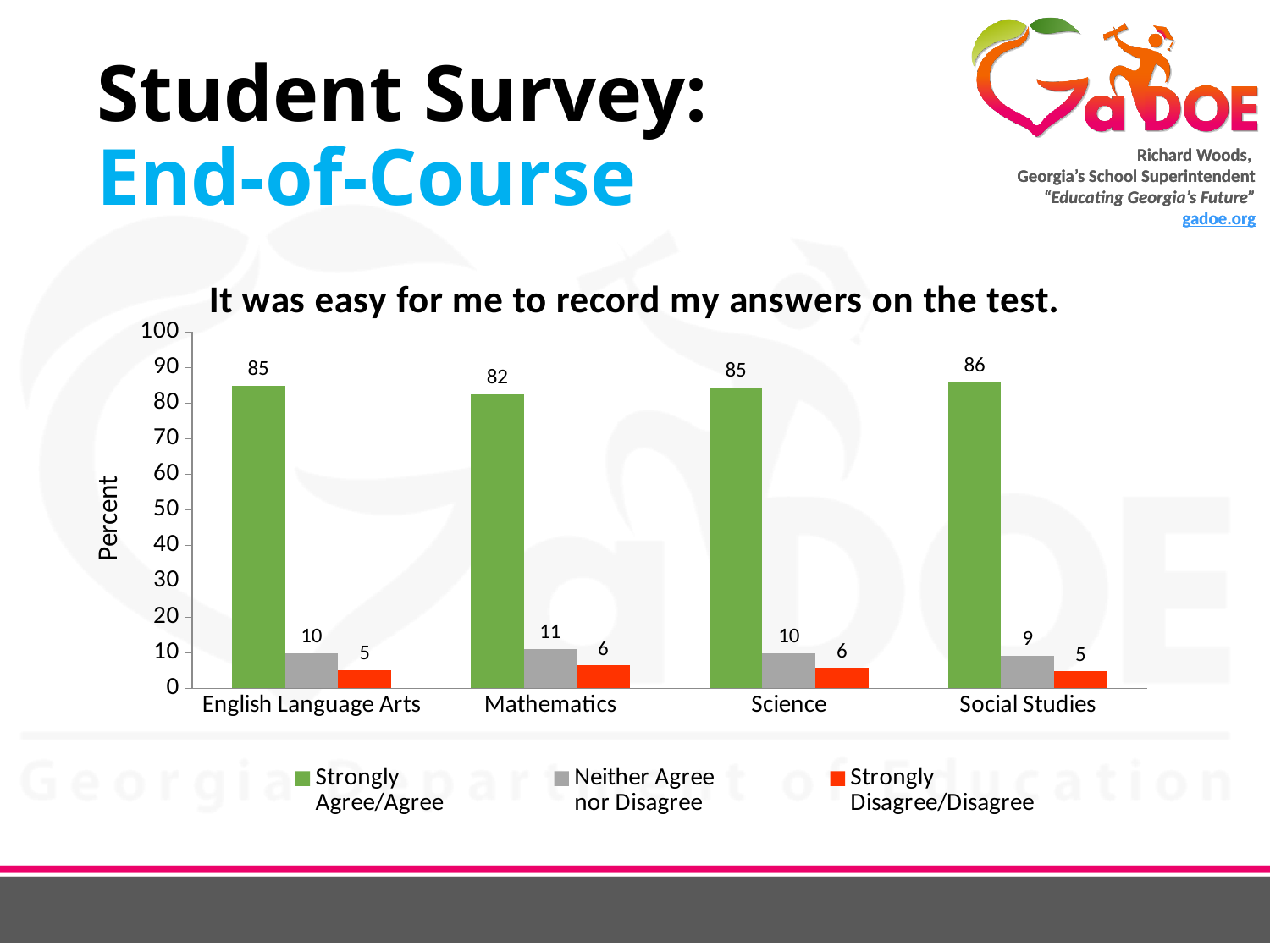
Which subject has the highest Strongly Agree/Agree value? Social Studies What is the Strongly Agree/Agree value for Mathematics? 82 What is the Strongly Disagree/Disagree value for Science? 6 What is the difference between the Strongly Agree/Agree values for Social Studies and Mathematics? 4 Which is larger, the Neither Agree nor Disagree value for Mathematics or for Social Studies? Mathematics Which subject has the lowest Strongly Agree/Agree value? Mathematics How many subjects are shown on the x axis? 4 What is the Neither Agree nor Disagree value for Social Studies? 9 What is the title of the chart? It was easy for me to record my answers on the test. How many series does the legend list? 3 What kind of chart is shown on the slide? bar chart Is the Strongly Agree/Agree value for English Language Arts greater or less than 80? greater